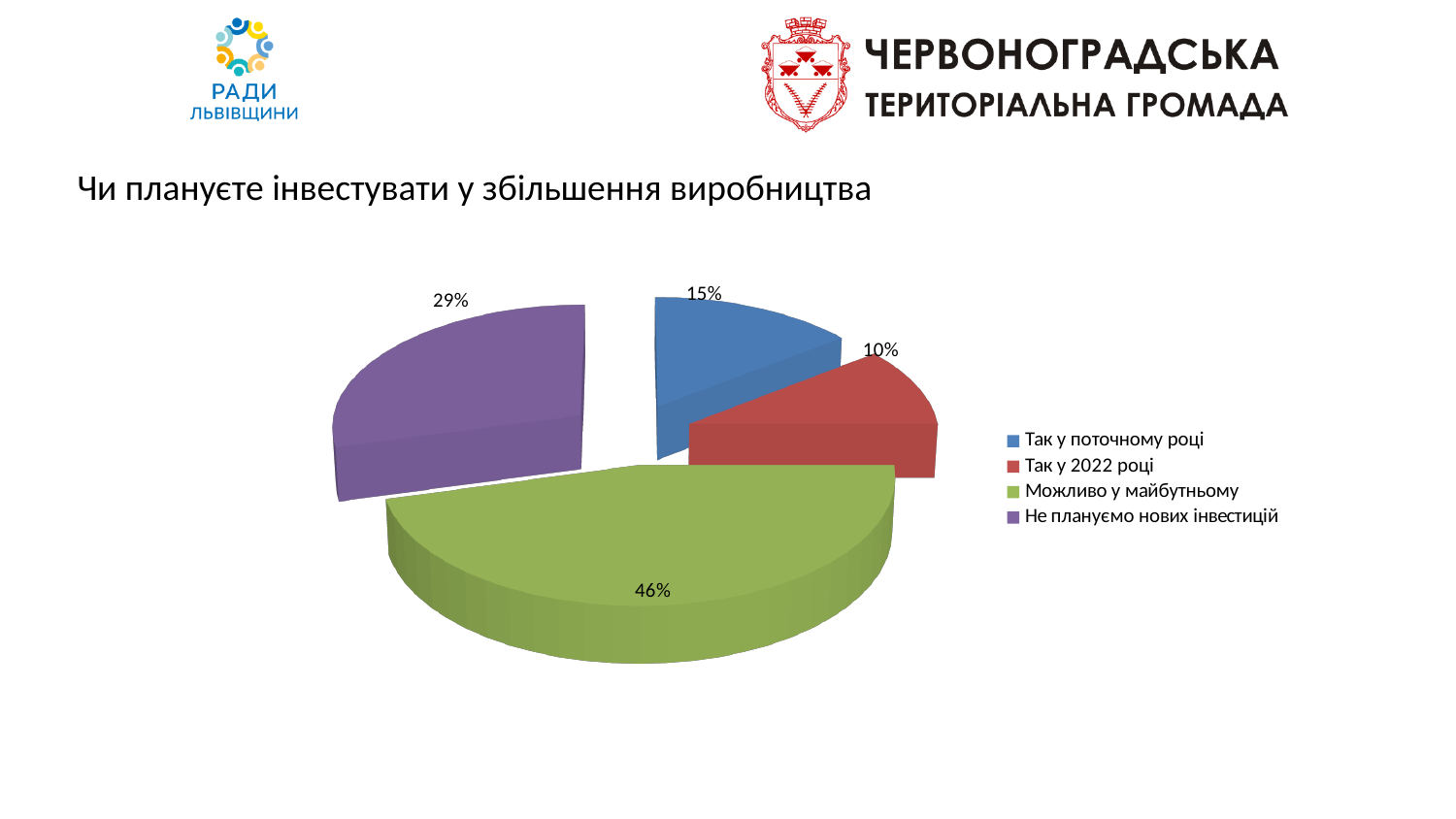
What is the value shown for "Так у поточному році"? 15% What kind of chart is shown on the slide? Pie chart What is the difference in percentage points between "Можливо у майбутньому" and "Не плануємо нових інвестицій"? 17% How many categories does the pie chart show? 4 What is the title of the chart? Чи плануєте інвестувати у збільшення виробництва What share of the pie does "Можливо у майбутньому" represent? 46% What colour is the slice for "Не плануємо нових інвестицій"? Purple What is the value shown for "Так у 2022 році"? 10% Which is larger: "Так у поточному році" or "Так у 2022 році"? Так у поточному році Which category has the largest slice of the pie? Можливо у майбутньому What is the value shown for "Не плануємо нових інвестицій"? 29% Which category has the smallest slice of the pie? Так у 2022 році